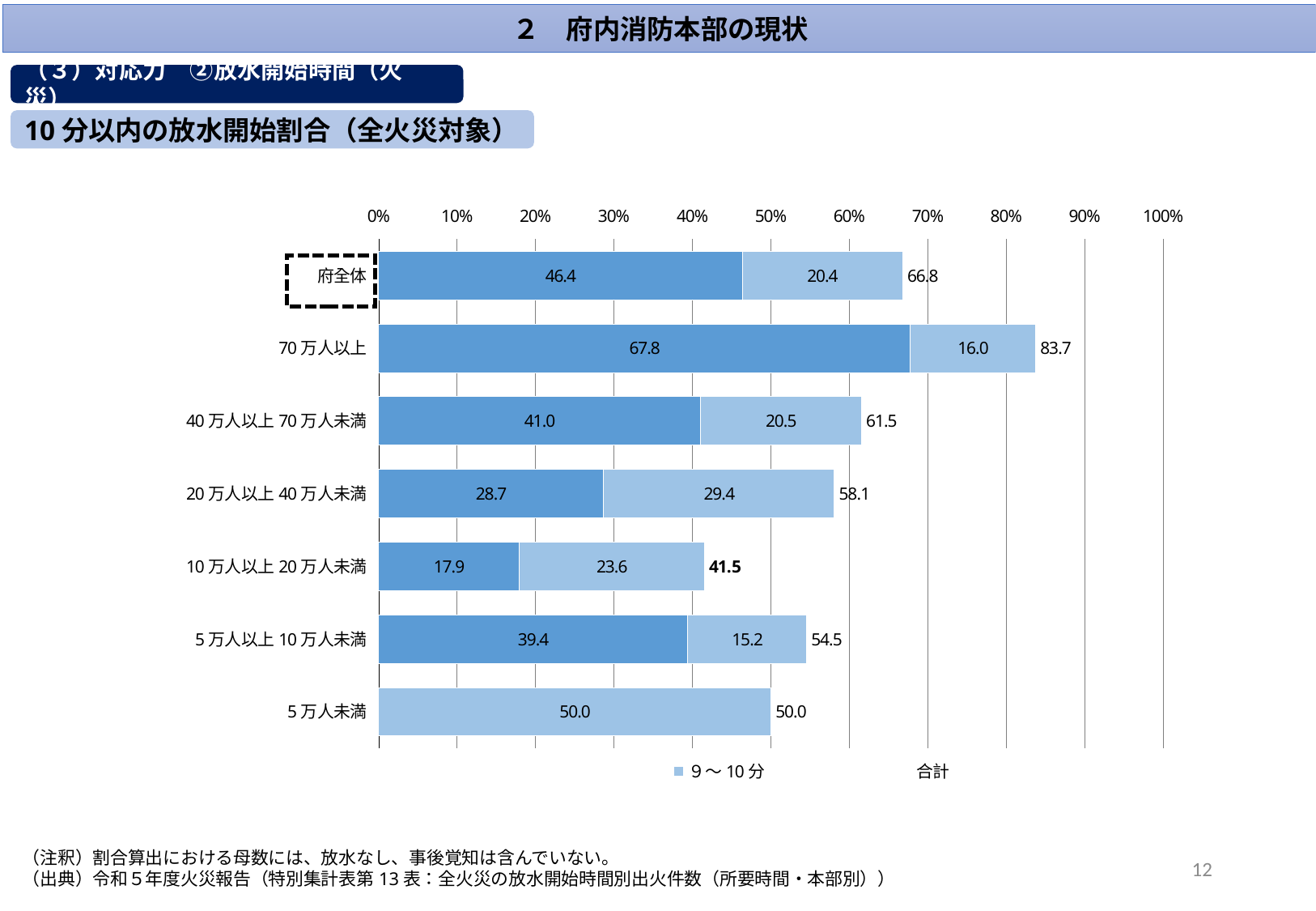
What is the 9～10分 value for 20万人以上40万人未満? 29.4 What is the title of the chart? 10分以内の放水開始割合（全火災対象） Which is larger, the 9～10分 value for 20万人以上40万人未満 or for 5万人以上10万人未満? 20万人以上40万人未満 What is the total (合計) value for 5万人未満? 50.0 Which category has the highest total (合計) value? 70万人以上 Which category has the largest 9～10分 value? 5万人未満 What is the total (合計) value for 府全体? 66.8 What kind of chart is shown on the slide? Stacked bar chart Which category has the lowest total (合計) value? 10万人以上20万人未満 Is the total value for 府全体 greater or less than 60%? greater What is the difference between the total for 70万人以上 and the total for 府全体? 16.9 How many categories (bars) are plotted in the chart? 7